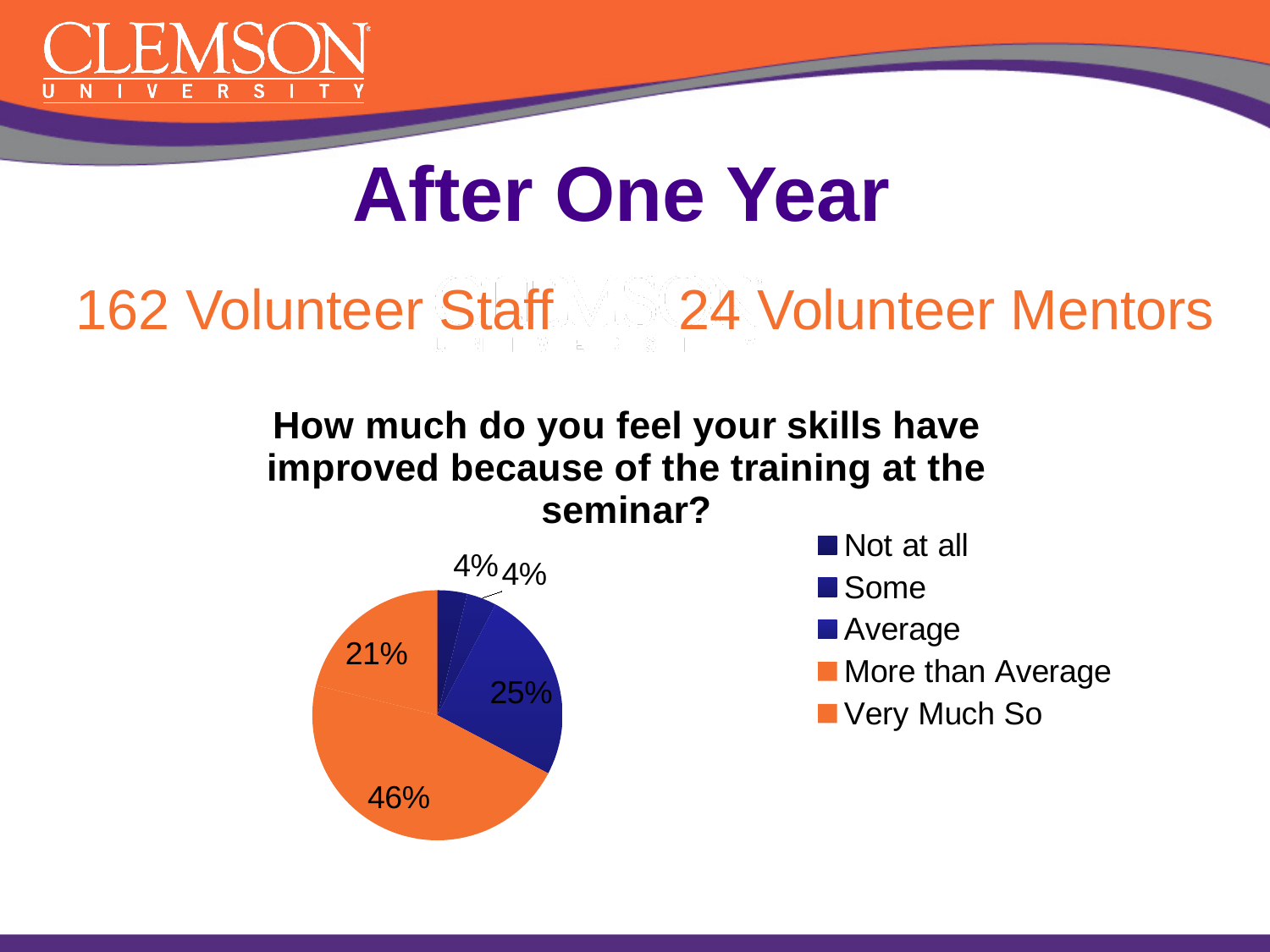
What is the difference between the "More than Average" share and the "Average" share? 21% Which is larger, the "Very Much So" share or the "Average" share? Average What share of the pie is labelled "Average"? 25% What kind of chart is shown on the slide? pie chart What share of the pie is labelled "More than Average"? 46% How many categories does the legend list? 5 What share of the pie is labelled "Very Much So"? 21% What is the combined share of "More than Average" and "Very Much So"? 67% Which legend entry is listed last? Very Much So What share of the pie is labelled "Not at all"? 4% What is the chart's title? How much do you feel your skills have improved because of the training at the seminar? Which category has the largest slice of the pie? More than Average